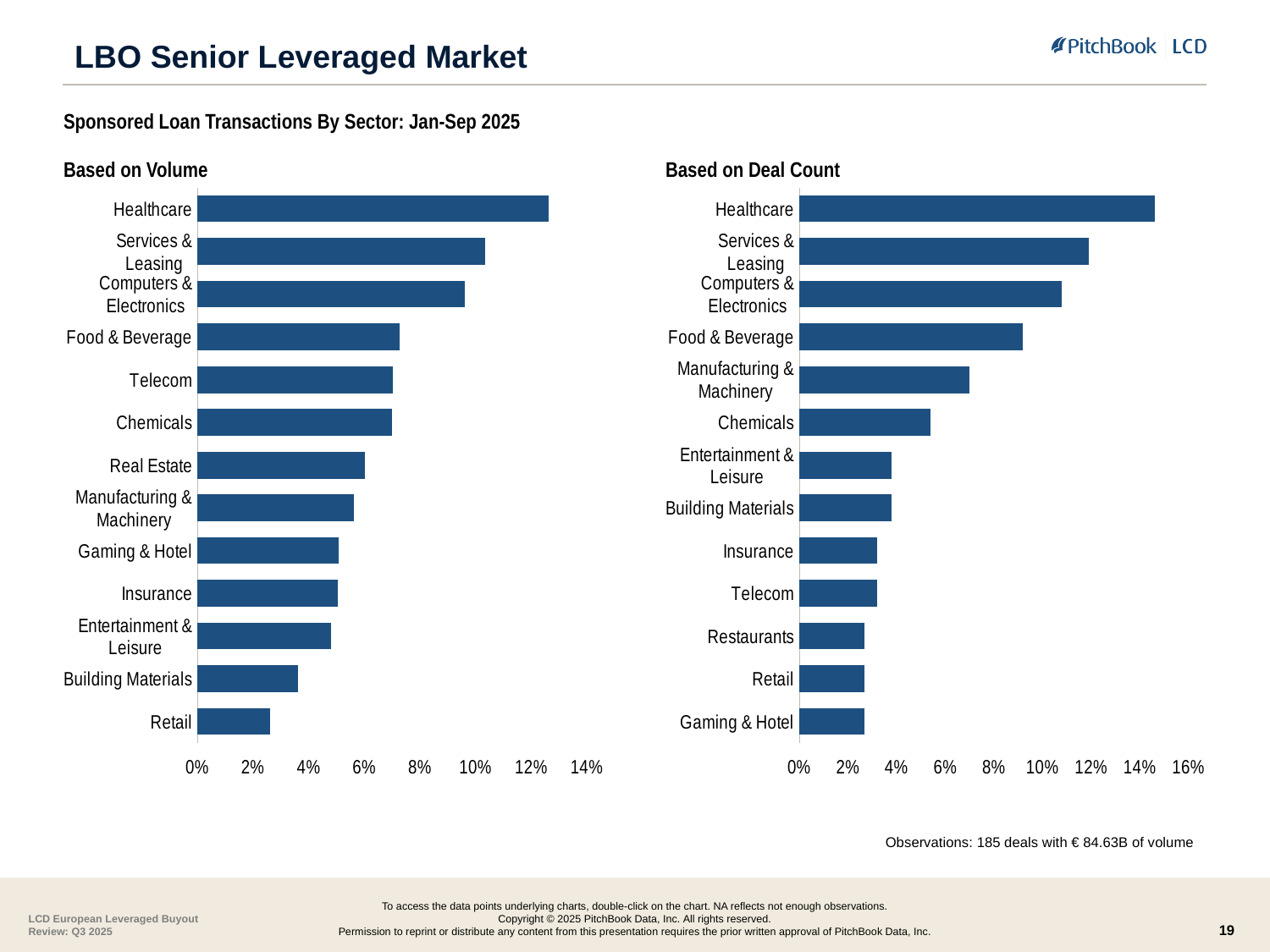
In the 'Based on Deal Count' chart, which is larger: Manufacturing & Machinery or Insurance? Manufacturing & Machinery In the 'Based on Volume' chart, which sector has the highest share? Healthcare In the 'Based on Volume' chart, which is larger: Services & Leasing or Food & Beverage? Services & Leasing In the 'Based on Deal Count' chart, is the value for Food & Beverage greater or less than 8%? greater In the 'Based on Volume' chart, which sector has the lowest share? Retail In the 'Based on Deal Count' chart, is the value for Healthcare greater or less than 14%? greater What type of chart is the 'Based on Deal Count' chart? Bar chart In the 'Based on Volume' chart, is the value for Retail greater or less than 4%? less In the 'Based on Deal Count' chart, which sector has the highest share? Healthcare How many sectors are shown in the 'Based on Volume' chart? 13